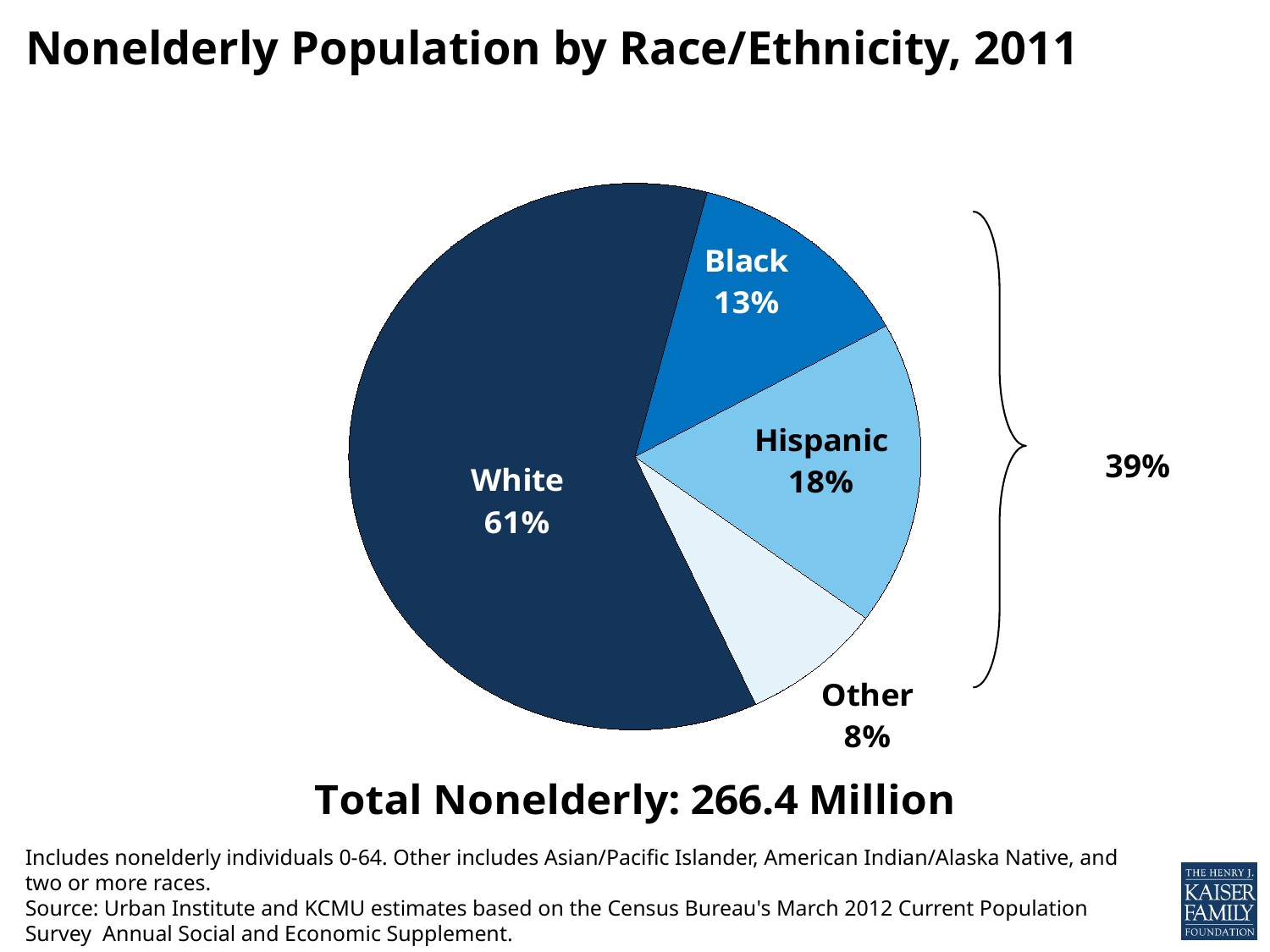
What kind of chart is shown on the slide? pie chart What combined share do the Black, Hispanic and Other groups make up, as shown by the bracket? 39% Which race/ethnicity group has the largest share of the pie? White What share of the nonelderly population is White? 61% What share of the nonelderly population is Black? 13% Which is larger, the Black share or the Other share? Black Which race/ethnicity group has the smallest share of the pie? Other How many slices does the pie chart have? 4 What share of the nonelderly population is Hispanic? 18% What share of the nonelderly population is Other? 8% What is the difference in percentage points between the Hispanic and Black shares? 5 percentage points What is the total nonelderly population stated below the chart? 266.4 Million